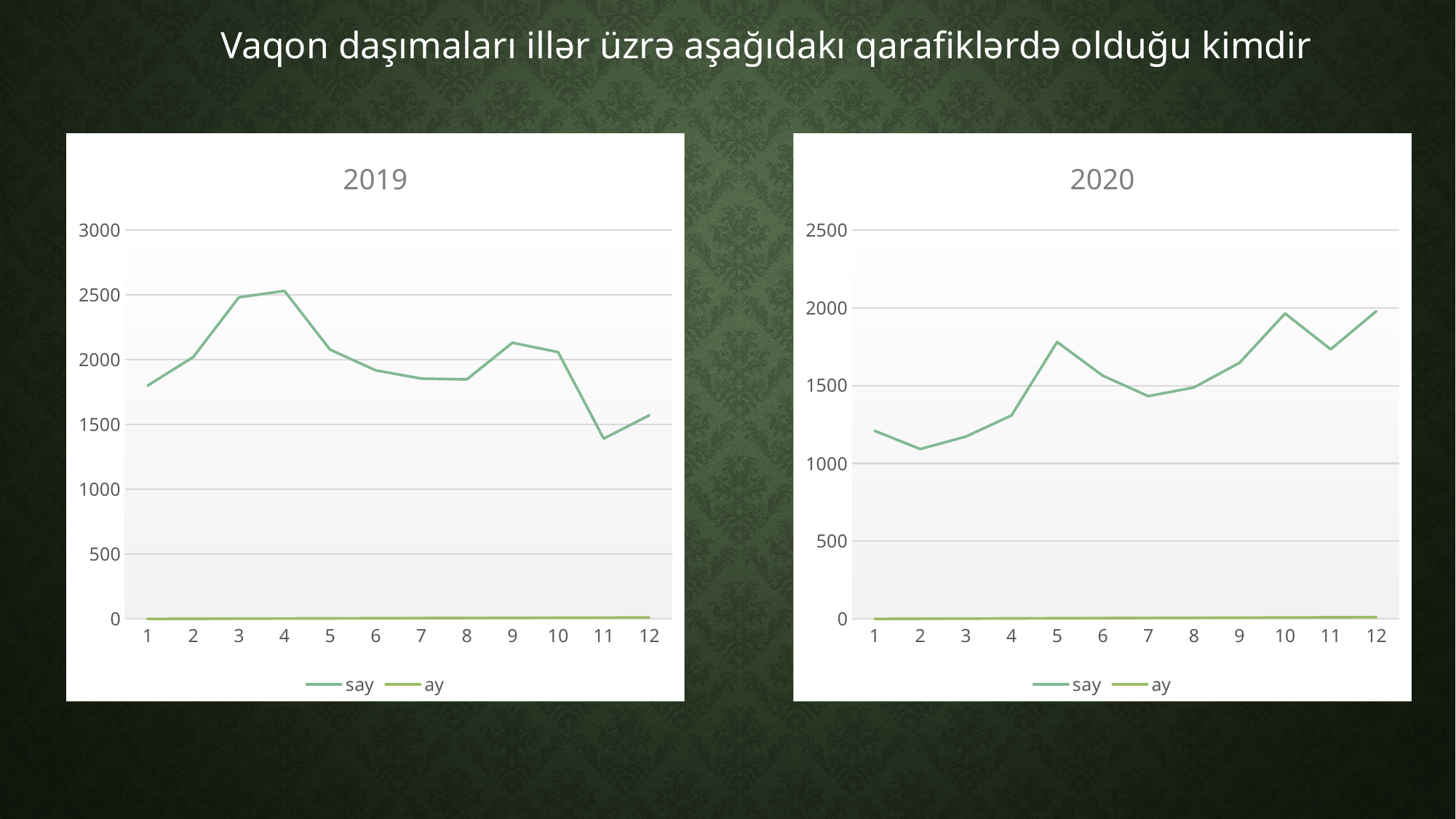
In the 2019 chart, which month has the lowest value for say? 11 In the 2019 chart, is the value for say in month 3 greater or less than 2000? greater How many points are plotted along the x axis of the 2019 chart? 12 In the 2019 chart, is the value for say in month 11 greater or less than 1500? less In the 2020 chart, which month has the lowest value for say? 2 In the 2020 chart, is the value for say in month 5 greater or less than 1500? greater What kind of chart is the 2019 chart? line chart What are the names of the two series in the legend of the 2019 chart? say and ay How many series does the legend of the 2020 chart list? 2 In the 2020 chart, does the say line rise or fall from month 7 to month 10? rise In the 2019 chart, which is larger for say: month 4 or month 11? month 4